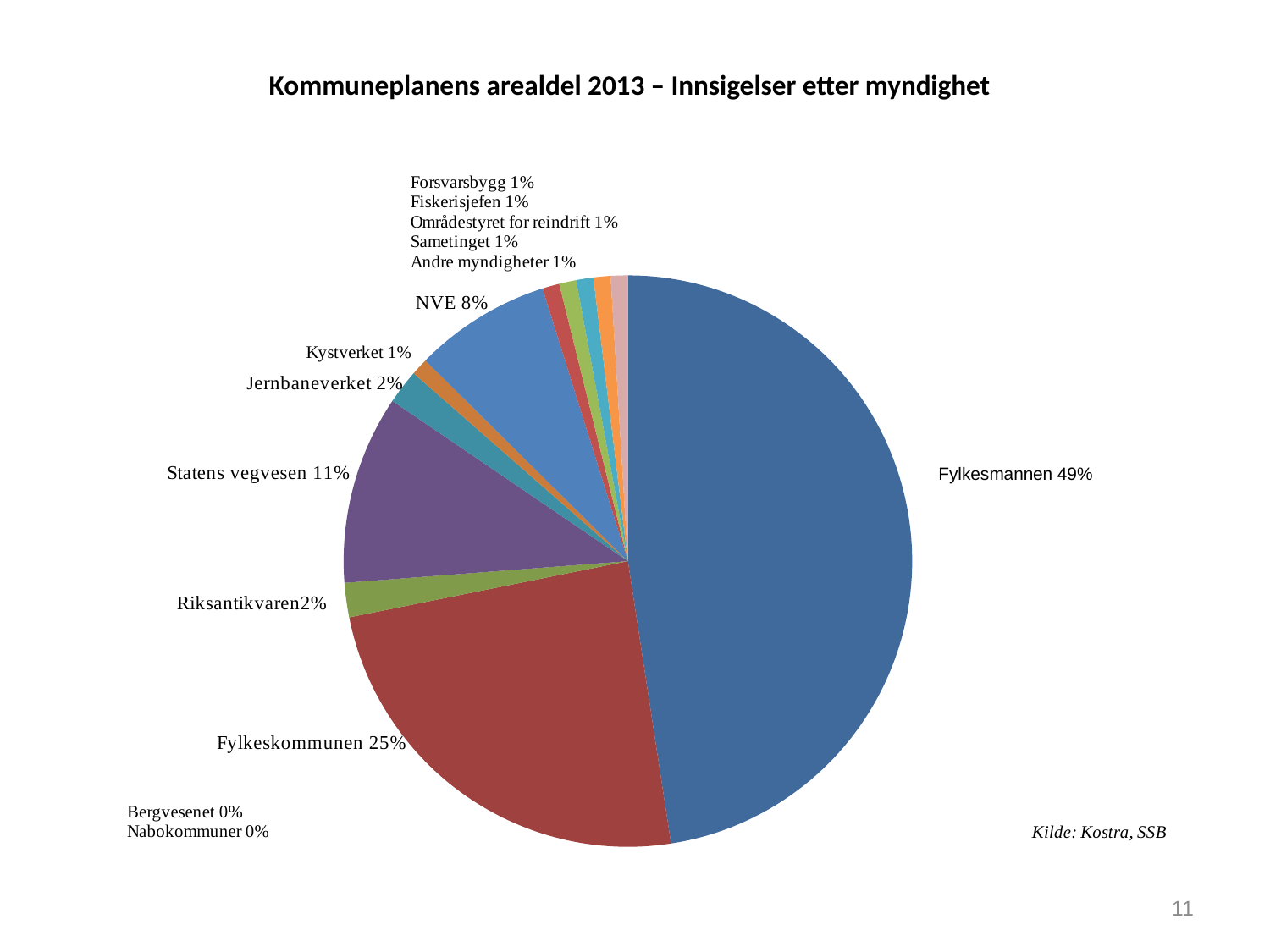
What is the value shown for Fylkeskommunen? 25% What type of chart is shown on the slide? pie chart What source is cited for the chart? Kilde: Kostra, SSB Which is larger, the share for Statens vegvesen or the share for NVE? Statens vegvesen What is the difference between the shares of Fylkesmannen and Fylkeskommunen? 24% What is the value shown for NVE? 8% What is the value shown for Jernbaneverket? 2% What is the value shown for Statens vegvesen? 11% What is the title of the chart? Kommuneplanens arealdel 2013 – Innsigelser etter myndighet Which authority has the largest slice of the pie? Fylkesmannen What share of the pie does Fylkesmannen account for? 49% How many categories are labelled in the pie chart? 14